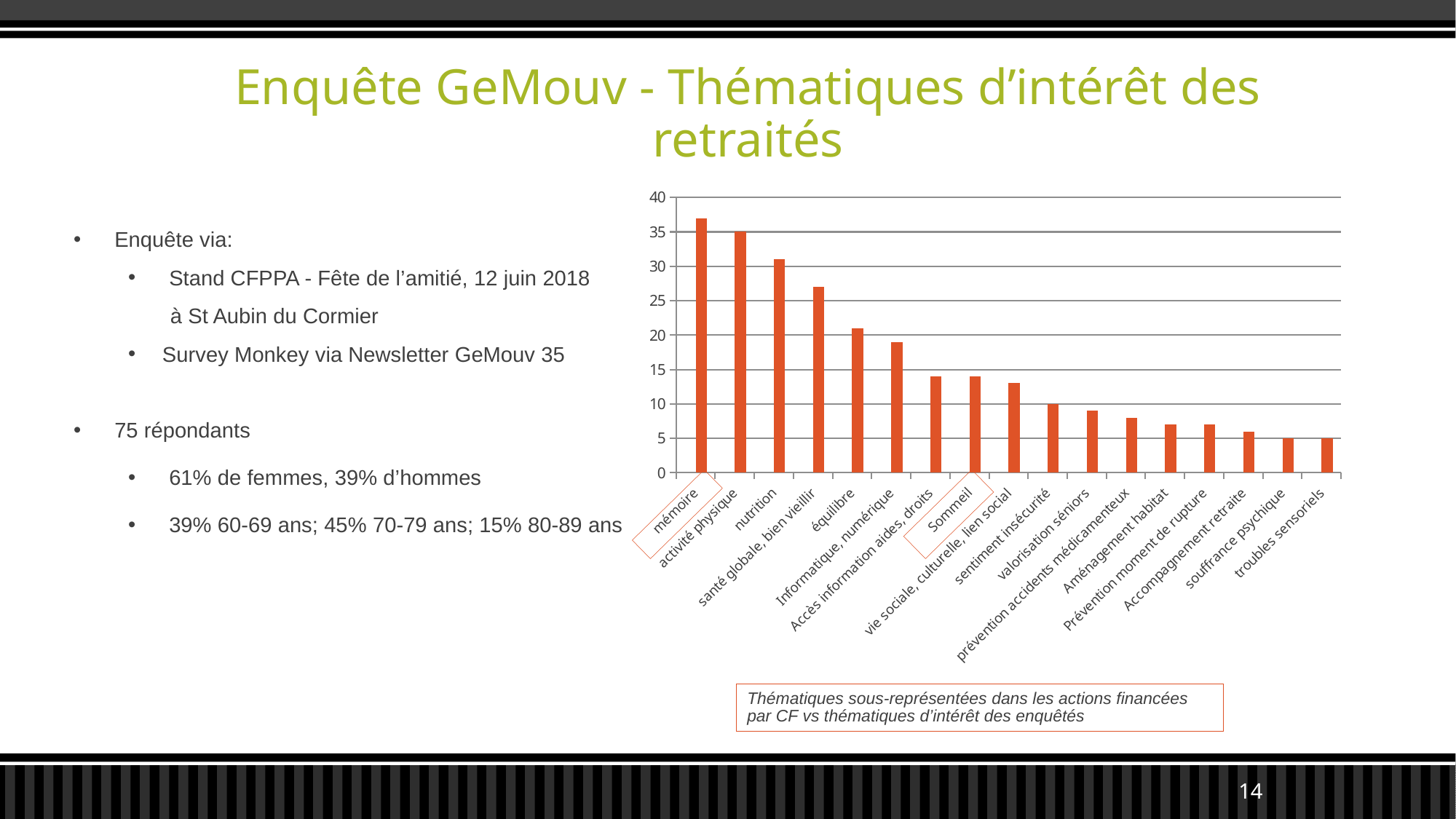
Is the value for santé globale, bien vieillir greater or less than 25? greater How many themes (categories) are plotted in the chart? 17 What kind of chart is shown on the slide? bar chart Which theme has the highest bar in the chart? mémoire Do the bar values rise or fall from left to right along the x axis? fall Which has the larger value, nutrition or équilibre? nutrition Is the value for valorisation séniors greater or less than 10? less What colour are the bars in the chart? orange Is the value for mémoire greater or less than 35? greater Which has the larger value, activité physique or Accès information aides, droits? activité physique